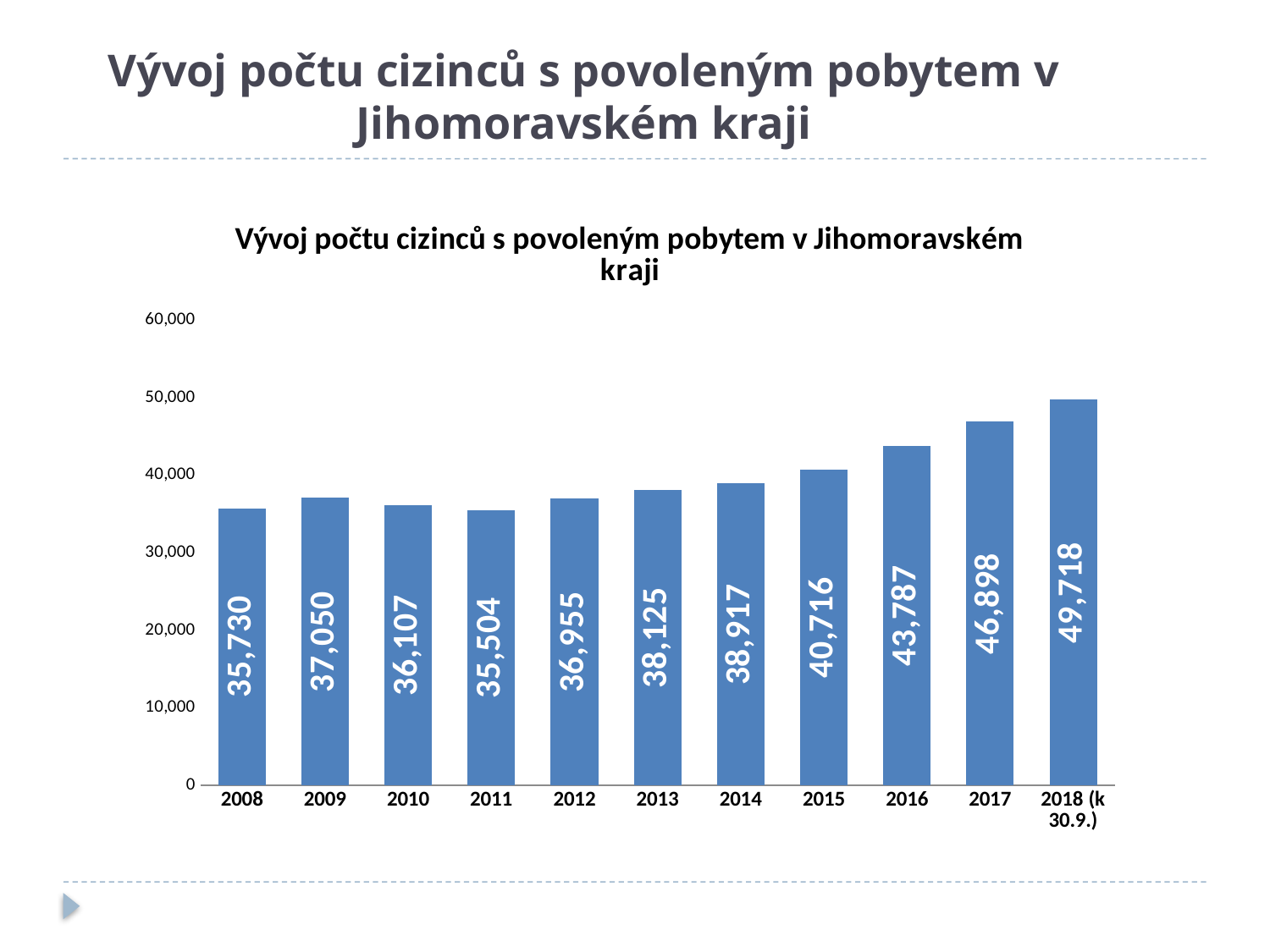
What is the value for 2015? 40,716 What kind of chart is shown? bar chart Do the values generally rise or fall from 2011 to 2018? rise Which year has the lowest value? 2011 What is the title of the chart? Vývoj počtu cizinců s povoleným pobytem v Jihomoravském kraji What is the value for 2018 (k 30.9.)? 49,718 What is the difference between the values for 2017 and 2016? 3,111 Which year has the highest value? 2018 (k 30.9.) How many years are shown on the x axis? 11 Is the value for 2014 greater or less than 40,000? less Which is larger, the value for 2009 or the value for 2010? 2009 What is the value for 2008? 35,730